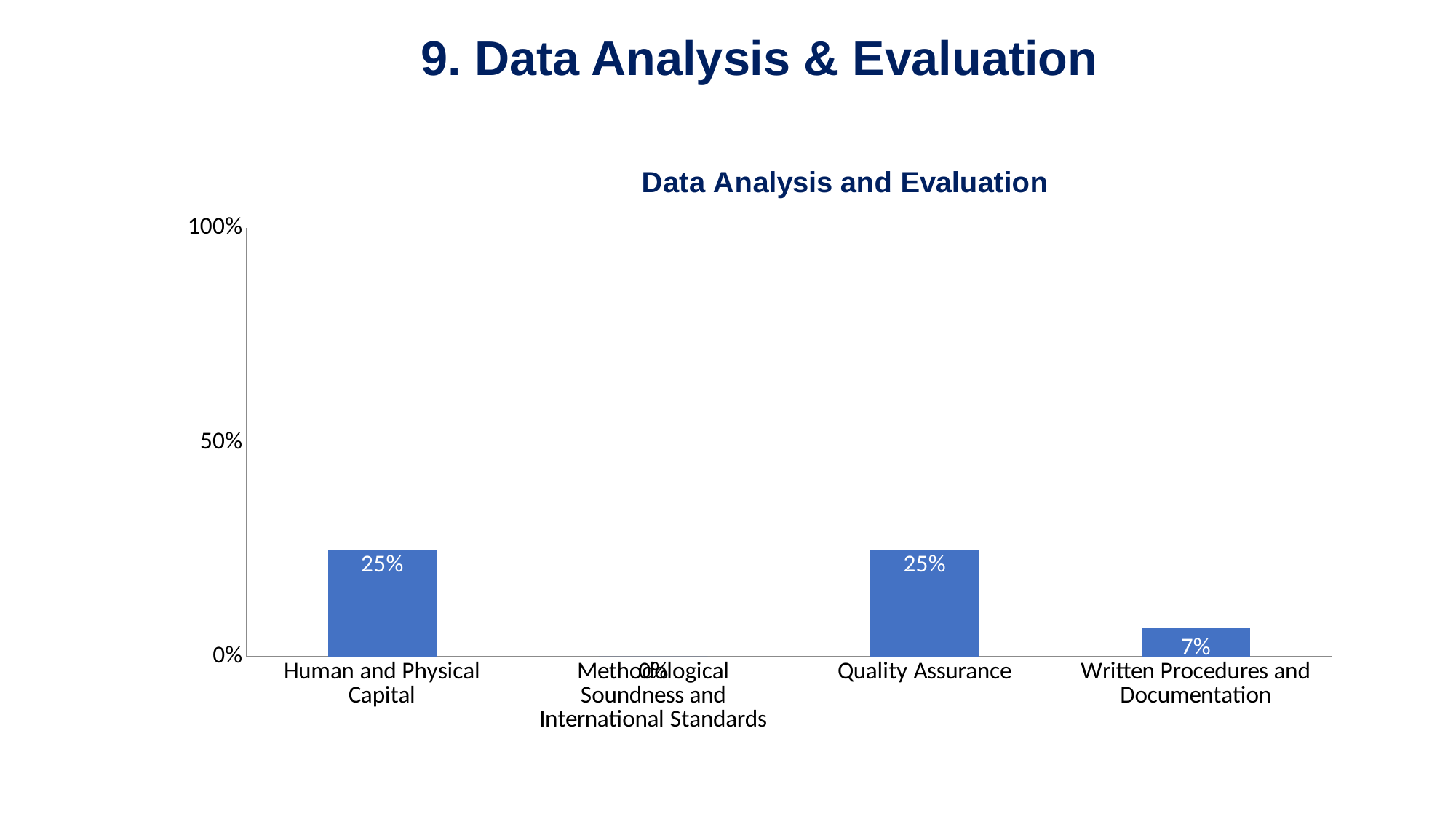
What is the difference between the values for Quality Assurance and Written Procedures and Documentation? 18% What is the title of the chart? Data Analysis and Evaluation What kind of chart is shown on the slide? bar chart What is the value for Quality Assurance? 25% What is the value for Methodological Soundness and International Standards? 0% What is the highest value shown on the y axis? 100% How many categories are shown on the x axis? 4 What is the value for Human and Physical Capital? 25% What is the value for Written Procedures and Documentation? 7% Which category has the lowest value? Methodological Soundness and International Standards Which is larger, the value for Human and Physical Capital or the value for Written Procedures and Documentation? Human and Physical Capital Is the value for Quality Assurance greater or less than 50%? less